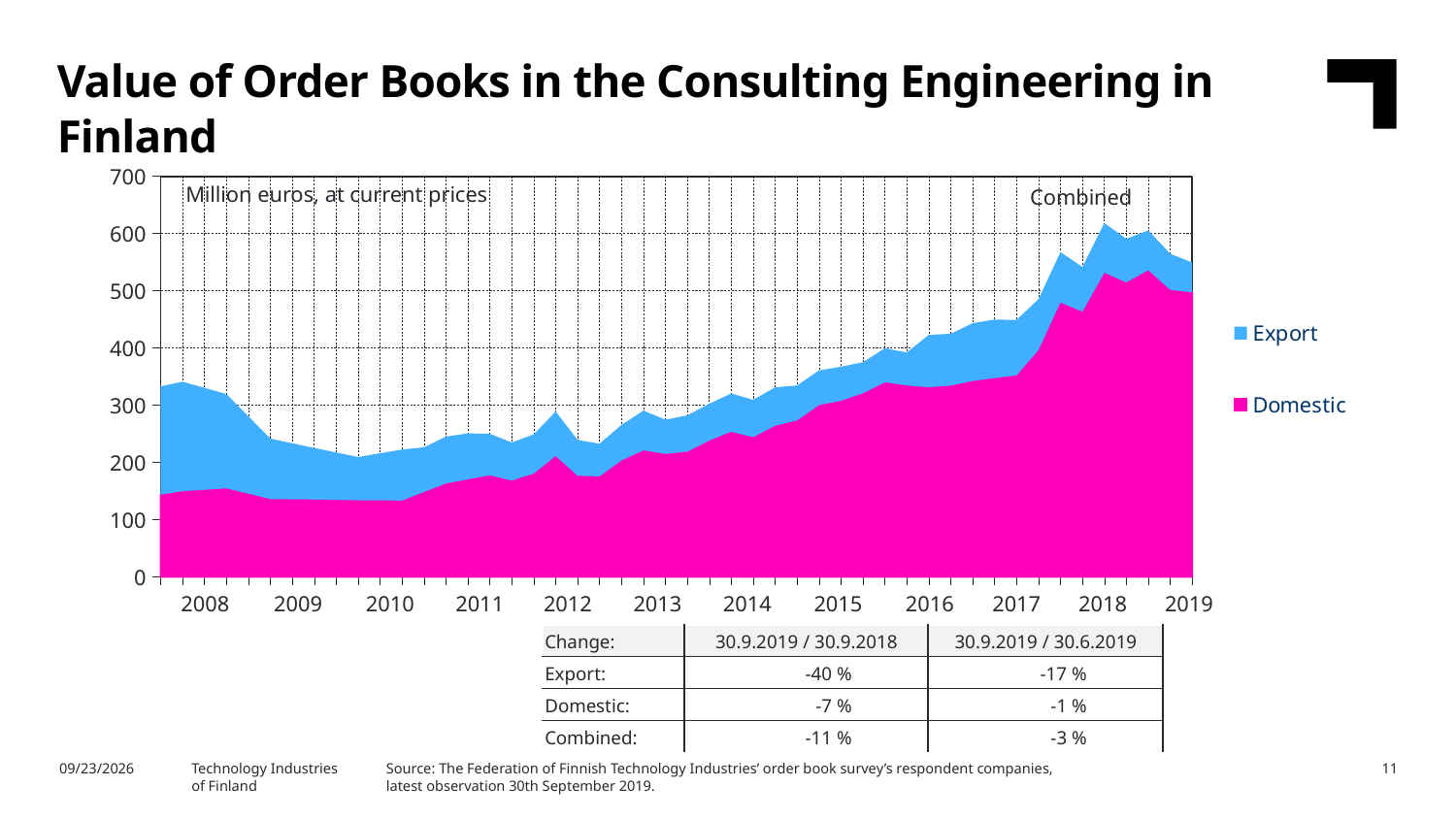
Is the combined value at the start of 2008 greater or less than 300? greater How many series does the chart legend list? 2 How many year labels are shown on the x axis? 12 Is the combined value during 2015 greater or less than 400? less Is the Domestic value at the start of 2010 greater or less than 200? less Which two series are listed in the chart legend? Export and Domestic What unit is stated in the label inside the chart area? Million euros, at current prices In which year does the combined value of order books reach its highest point? 2018 What kind of chart is shown on the slide? Stacked area chart In 2019, which series is larger, Export or Domestic? Domestic Does the combined value of order books rise or fall between 2010 and 2018? Rise